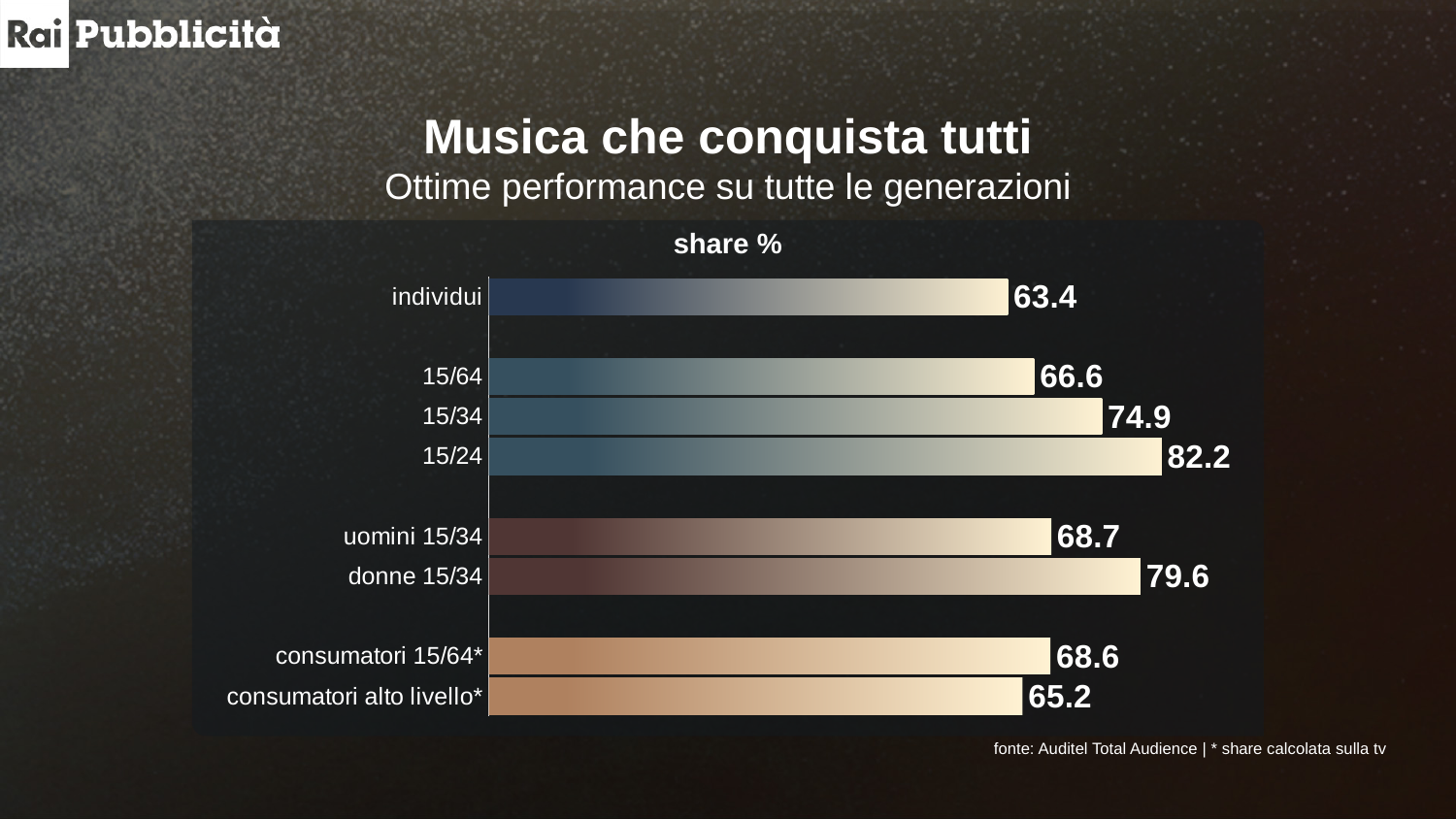
What is the title of the chart? share % What kind of chart is shown on the slide? bar chart What is the share % value for consumatori alto livello*? 65.2 What is the difference in share % between donne 15/34 and uomini 15/34? 10.9 What is the share % value for individui? 63.4 What is the share % value for donne 15/34? 79.6 Which has a higher share %, 15/34 or consumatori 15/64*? 15/34 Which category has the highest share %? 15/24 How many categories are shown in the chart? 8 What is the difference in share % between 15/24 and 15/64? 15.6 What is the share % value for 15/24? 82.2 Which category has the lowest share %? individui